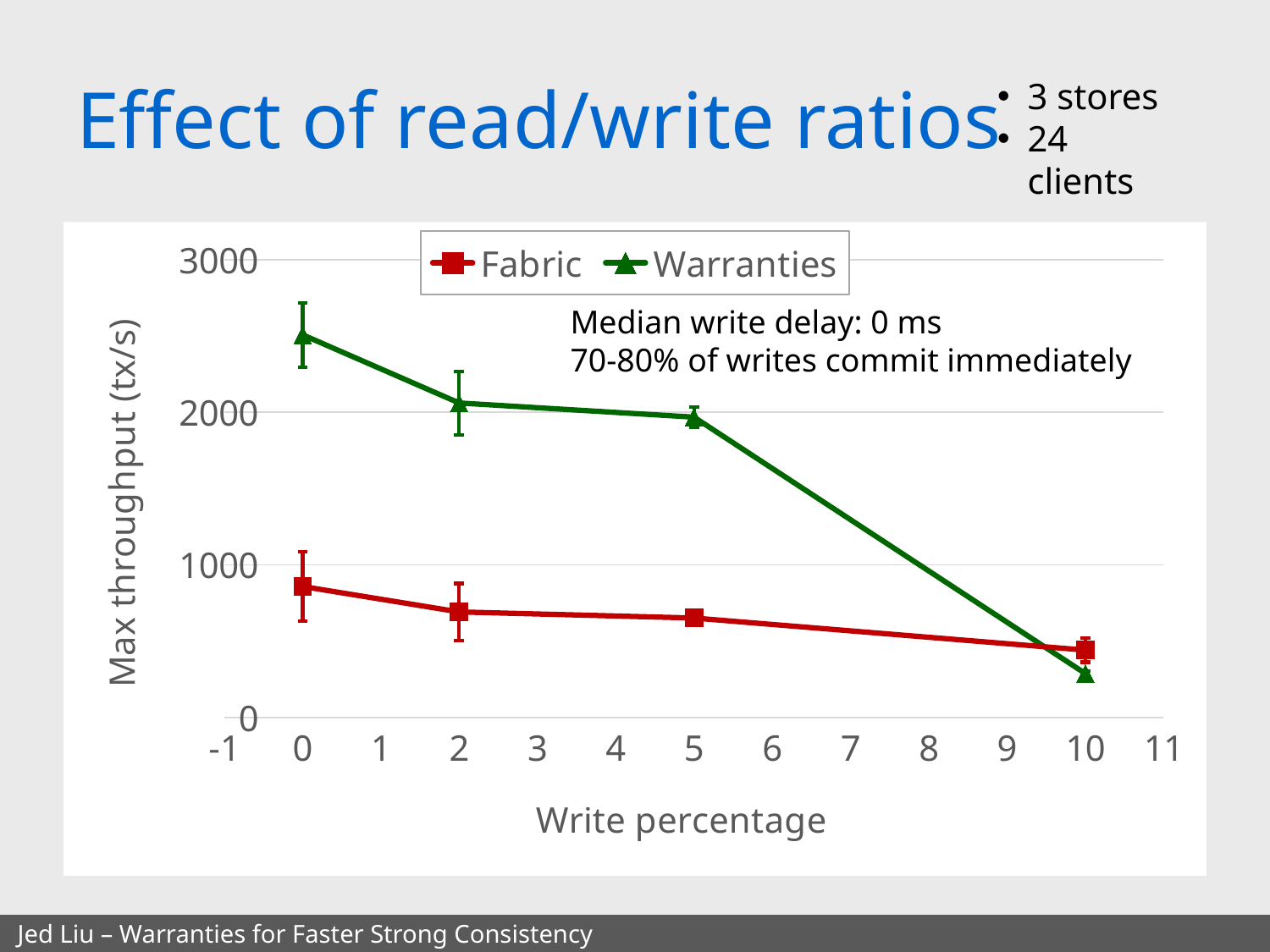
How many data points are plotted for the Warranties series? 4 At write percentage 0, which series has the higher max throughput, Fabric or Warranties? Warranties What is the label of the y axis? Max throughput (tx/s) Does the Warranties series rise or fall as the write percentage increases? fall Is the Warranties value at write percentage 10 greater or less than 1000? less How many series does the legend list? 2 What kind of chart is shown on the slide? line chart Is the Fabric value at write percentage 5 greater or less than 1000? less Is the Fabric value at write percentage 0 greater or less than 1000? less Which colour is used for the Fabric series? red At write percentage 10, which series has the higher max throughput, Fabric or Warranties? Fabric